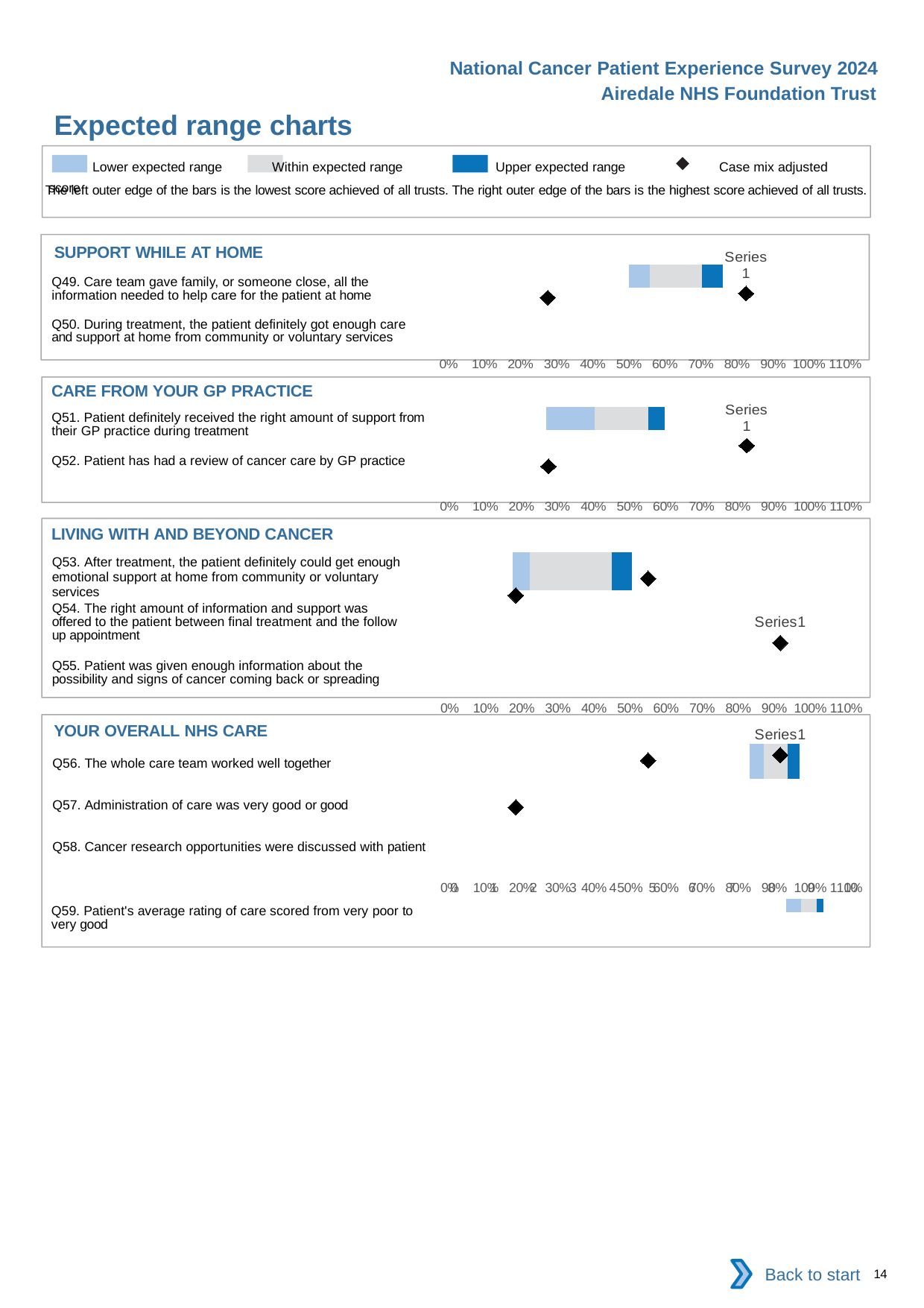
According to the legend, what does the black diamond marker represent? Case mix adjusted score What kind of chart is used in the SUPPORT WHILE AT HOME section? bar chart How many expected range chart sections are shown on the slide? 4 In the CARE FROM YOUR GP PRACTICE chart, is the rightmost diamond marker greater or less than 70%? greater How many entries does the legend at the top of the slide list? 4 What is the highest tick label shown on the x axis of the CARE FROM YOUR GP PRACTICE chart? 110% How many questions are listed in the CARE FROM YOUR GP PRACTICE chart? 2 How many questions are listed in the LIVING WITH AND BEYOND CANCER chart? 3 What is the title of the slide? Expected range charts In the SUPPORT WHILE AT HOME chart, is the leftmost diamond marker greater or less than 50%? less